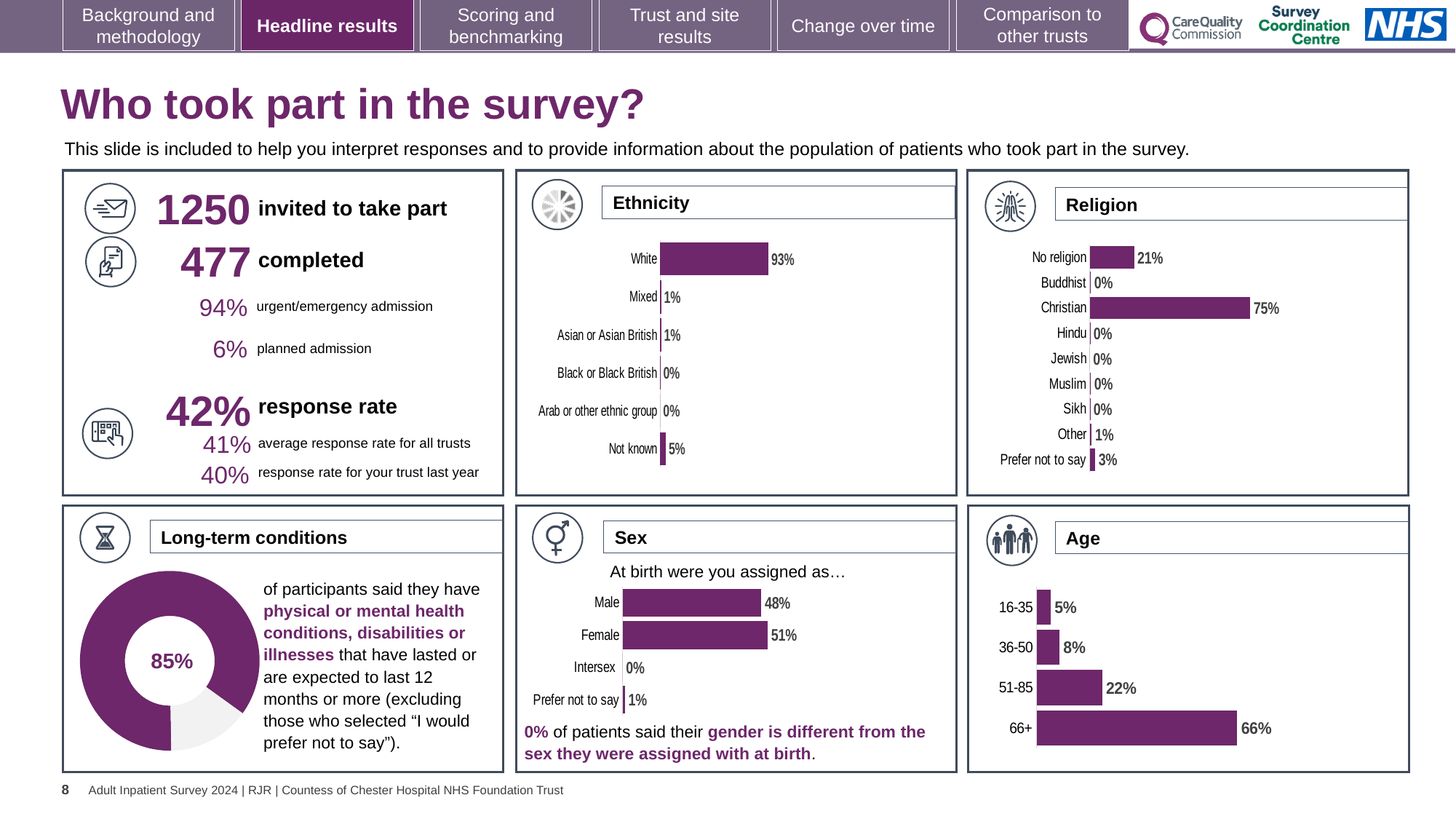
In the Age chart, what is the difference between 51-85 and 36-50? 14% What kind of chart is the Long-term conditions chart? doughnut chart In the Ethnicity chart, what is the value for Not known? 5% In the Ethnicity chart, what is the value for White? 93% In the Sex chart, which is larger, Male or Female? Female In the Religion chart, what is the value for Christian? 75% In the Age chart, what is the value for 66+? 66% In the Age chart, do the values rise or fall as age increases from 16-35 to 66+? rise In the Religion chart, what is the difference between Christian and No religion? 54% In the Sex chart, what is the value for Prefer not to say? 1% How many categories does the Religion chart show? 9 In the Ethnicity chart, which category has the highest value? White